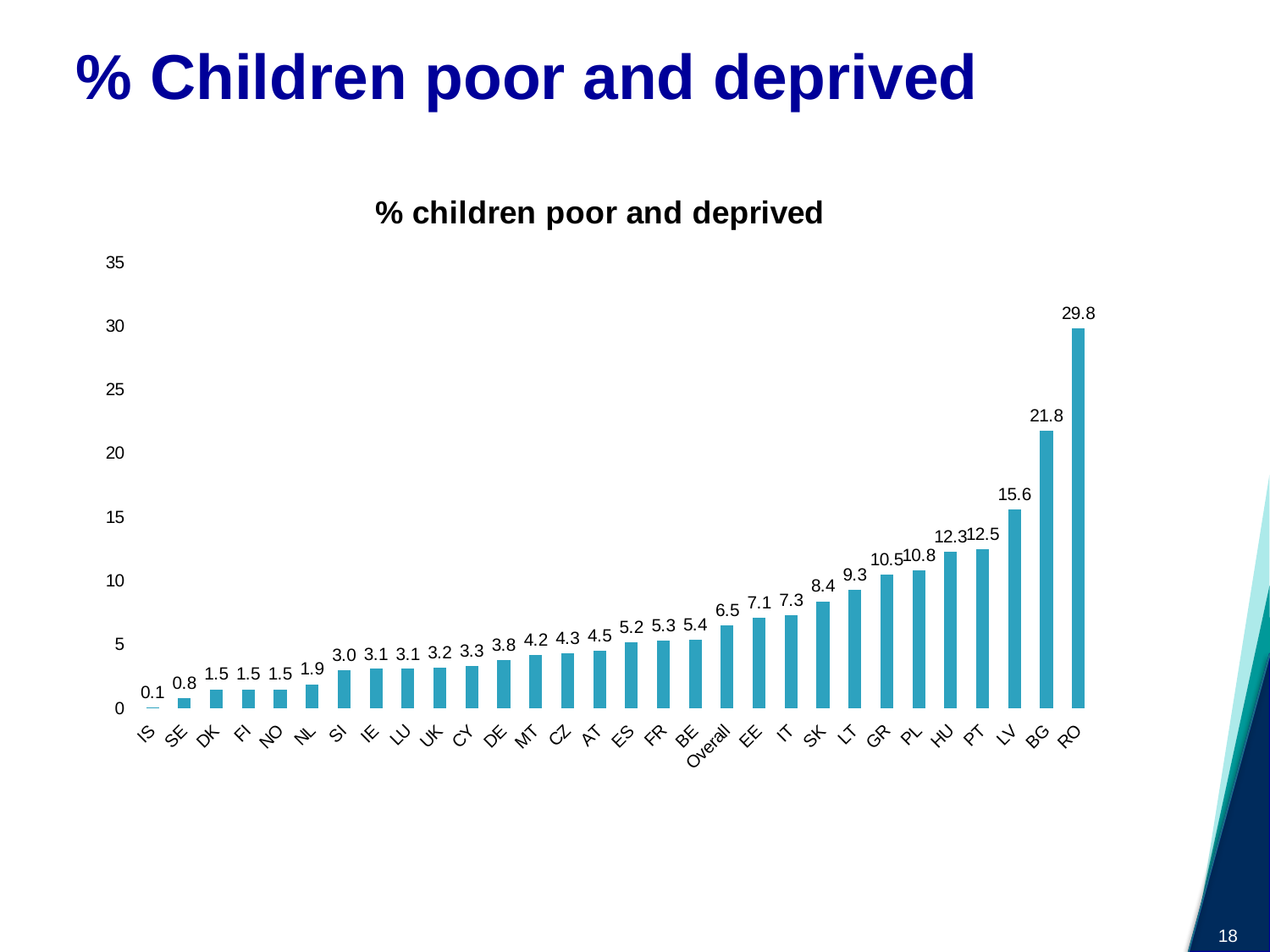
Is the value for BG greater or less than 20? greater Which category has the highest value? RO What kind of chart is this? bar chart What is the title of the chart? % children poor and deprived How many categories are shown on the x axis? 30 What is the value for UK? 3.2 Do the values rise or fall from left to right along the x axis? rise Which category has the lowest value? IS Which is larger, the value for LV or the value for PT? LV What is the difference between the values for RO and BG? 8.0 What is the value for Overall? 6.5 What is the value for RO? 29.8